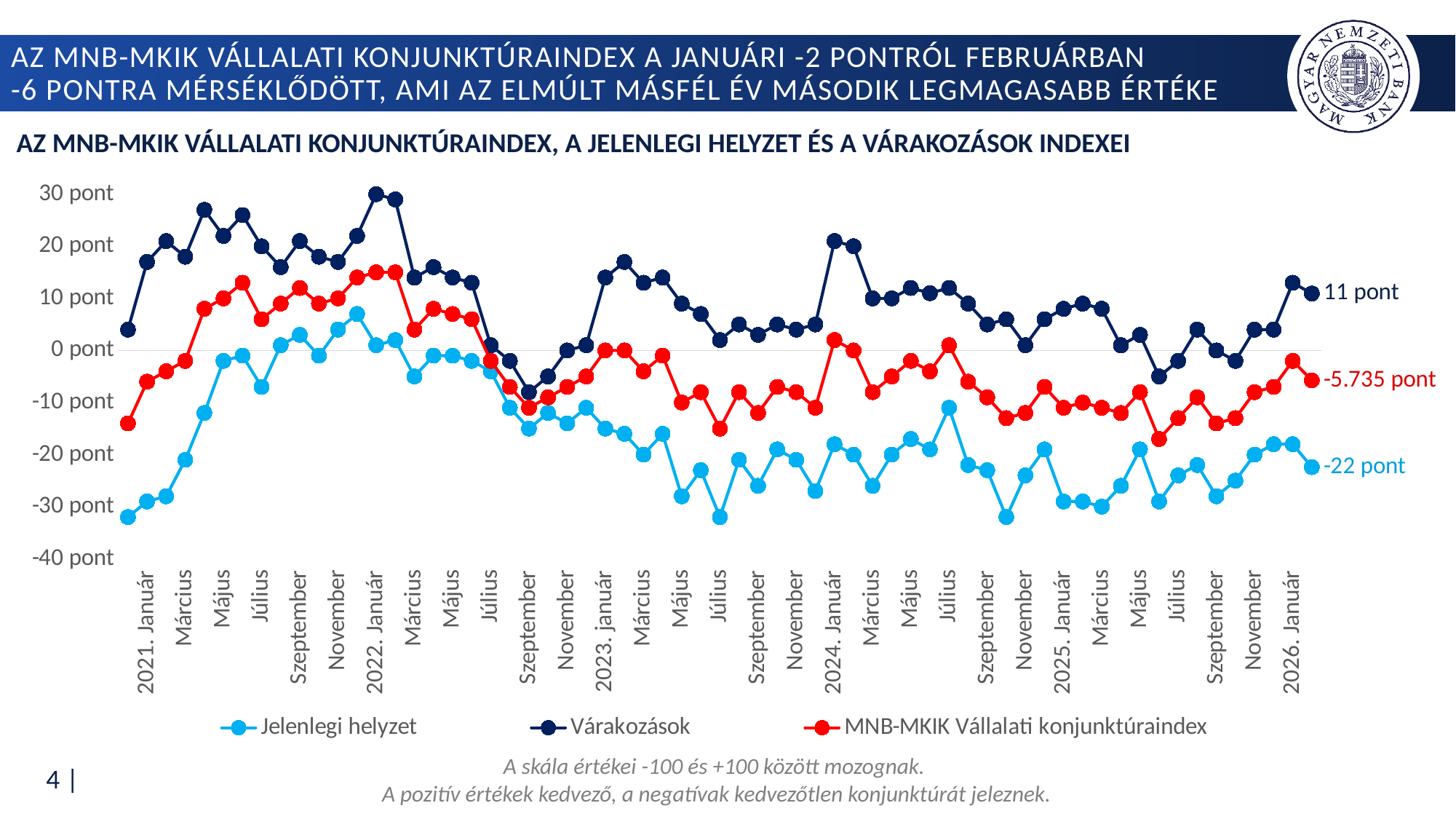
What colour is the Jelenlegi helyzet line? light blue Does the Jelenlegi helyzet series rise or fall between 2021. Január and 2022. Január? rise Which series has the lowest value at the end of the chart? Jelenlegi helyzet Which series has the highest value at the end of the chart? Várakozások What is the final labelled value of the MNB-MKIK Vállalati konjunktúraindex series? -5.735 pont What kind of chart is shown on the slide? line chart What is the final labelled value of the Várakozások series? 11 pont How many series does the legend list? 3 What is the difference between the final labelled values of Várakozások and Jelenlegi helyzet? 33 pont What is the final labelled value of the Jelenlegi helyzet series? -22 pont Is the value of Várakozások in 2022. Január greater or less than 20 pont? greater